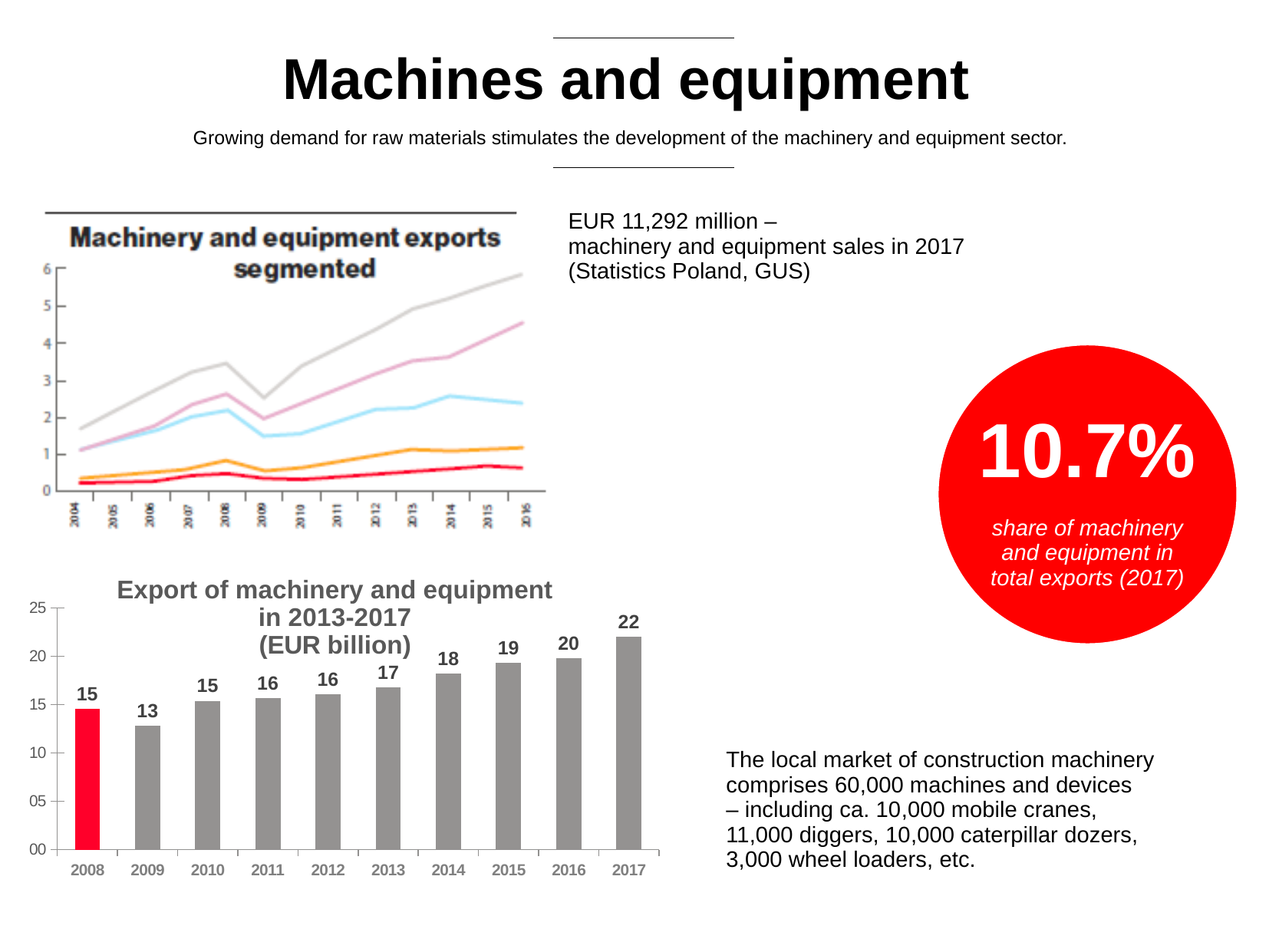
In the bar chart 'Export of machinery and equipment in 2013-2017 (EUR billion)', how many years are shown on the x axis? 10 In the bar chart 'Export of machinery and equipment in 2013-2017 (EUR billion)', which year has the highest value? 2017 In the bar chart 'Export of machinery and equipment in 2013-2017 (EUR billion)', what is the difference between the values for 2017 and 2013? 5 In the bar chart 'Export of machinery and equipment in 2013-2017 (EUR billion)', what is the value for 2017? 22 In the bar chart 'Export of machinery and equipment in 2013-2017 (EUR billion)', which is larger, the value for 2008 or the value for 2009? 2008 In the bar chart 'Export of machinery and equipment in 2013-2017 (EUR billion)', do the values generally rise or fall from 2009 to 2017? rise In the bar chart 'Export of machinery and equipment in 2013-2017 (EUR billion)', what is the value for 2014? 18 What kind of chart is 'Machinery and equipment exports segmented'? line chart In the bar chart 'Export of machinery and equipment in 2013-2017 (EUR billion)', which year has the lowest value? 2009 What kind of chart is 'Export of machinery and equipment in 2013-2017 (EUR billion)'? bar chart In the line chart 'Machinery and equipment exports segmented', is the value of the top (grey) line in 2016 greater or less than 5? greater In the bar chart 'Export of machinery and equipment in 2013-2017 (EUR billion)', what is the value for 2009? 13